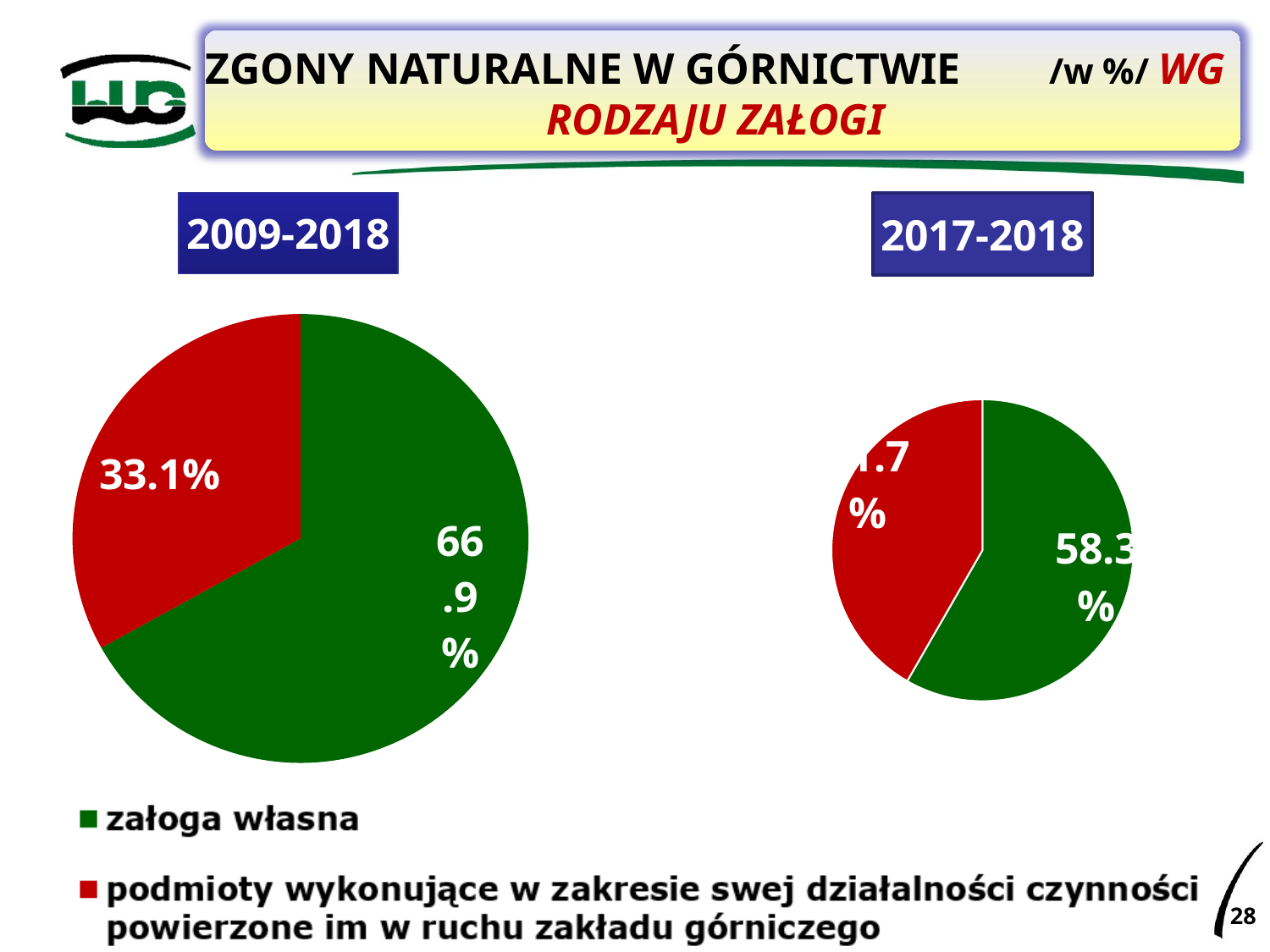
How many categories does the legend list for the pie charts? 2 In the 2009-2018 pie chart, what share is shown for załoga własna? 66.9% In the 2009-2018 pie chart, what is the difference in percentage points between the załoga własna share and the podmioty wykonujące share? 33.8 How many slices does the 2017-2018 pie chart have? 2 What kind of chart is used for the 2009-2018 data? Pie chart In the 2017-2018 pie chart, what share is shown for załoga własna? 58.3% In the 2017-2018 pie chart, which category has the larger share? załoga własna In the 2009-2018 pie chart, what share is shown for podmioty wykonujące w zakresie swej działalności czynności powierzone im w ruchu zakładu górniczego? 33.1% Is the share of załoga własna larger in the 2009-2018 chart or in the 2017-2018 chart? 2009-2018 In the 2009-2018 pie chart, which category has the larger share? załoga własna What colour represents załoga własna in the pie charts? Green What is the title of the slide containing the pie charts? ZGONY NATURALNE W GÓRNICTWIE /w %/ WG RODZAJU ZAŁOGI